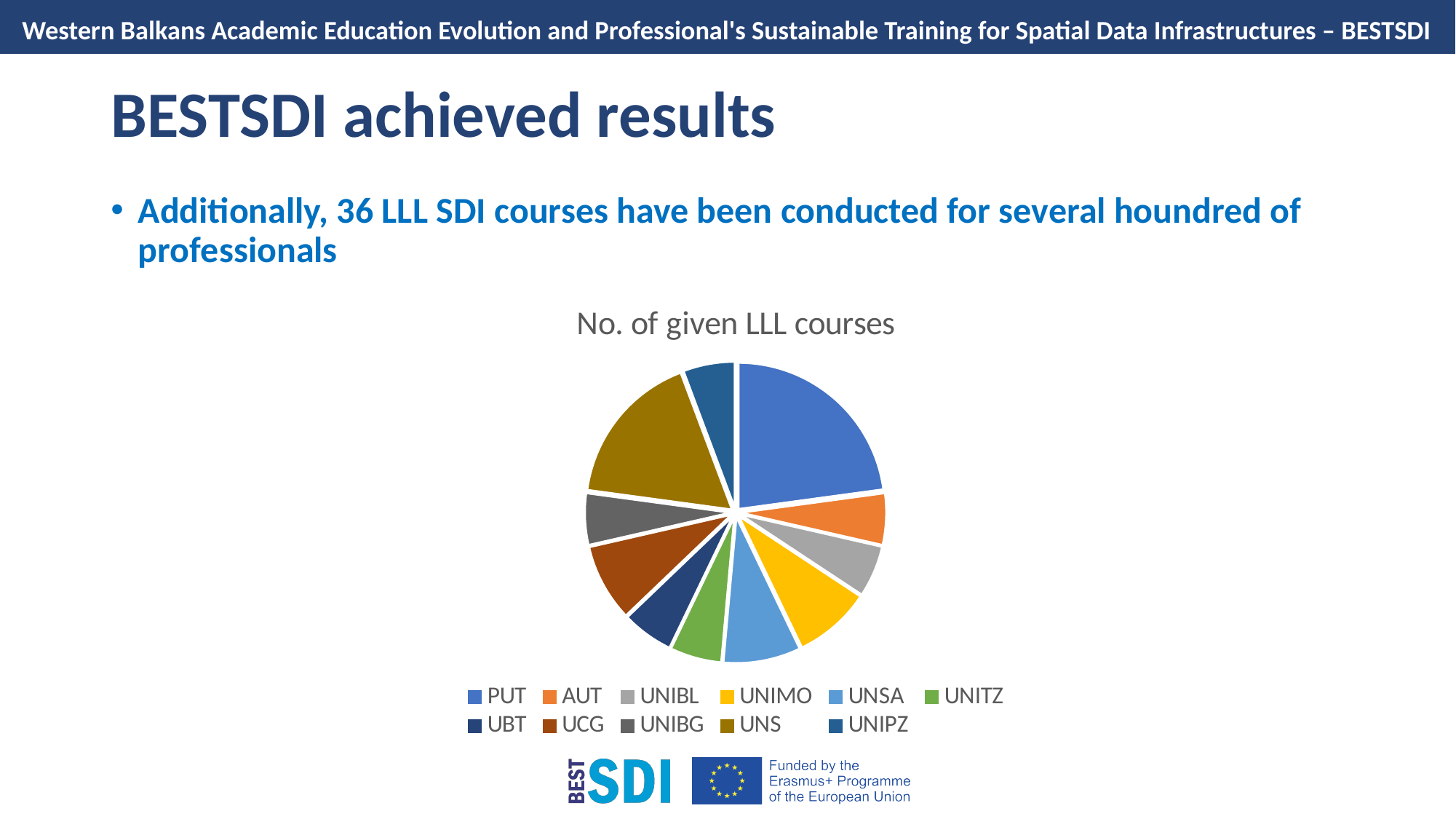
Which slice is larger, UCG or UNITZ? UCG Which category has the largest slice in the pie chart? PUT Which slice is larger, PUT or UNS? PUT What kind of chart is shown on the slide? pie chart Which slice is larger, UNS or UNIBL? UNS What colour is the PUT slice in the pie chart? blue How many categories (slices) does the pie chart have? 11 What is the title of the chart? No. of given LLL courses How many entries does the chart legend list? 11